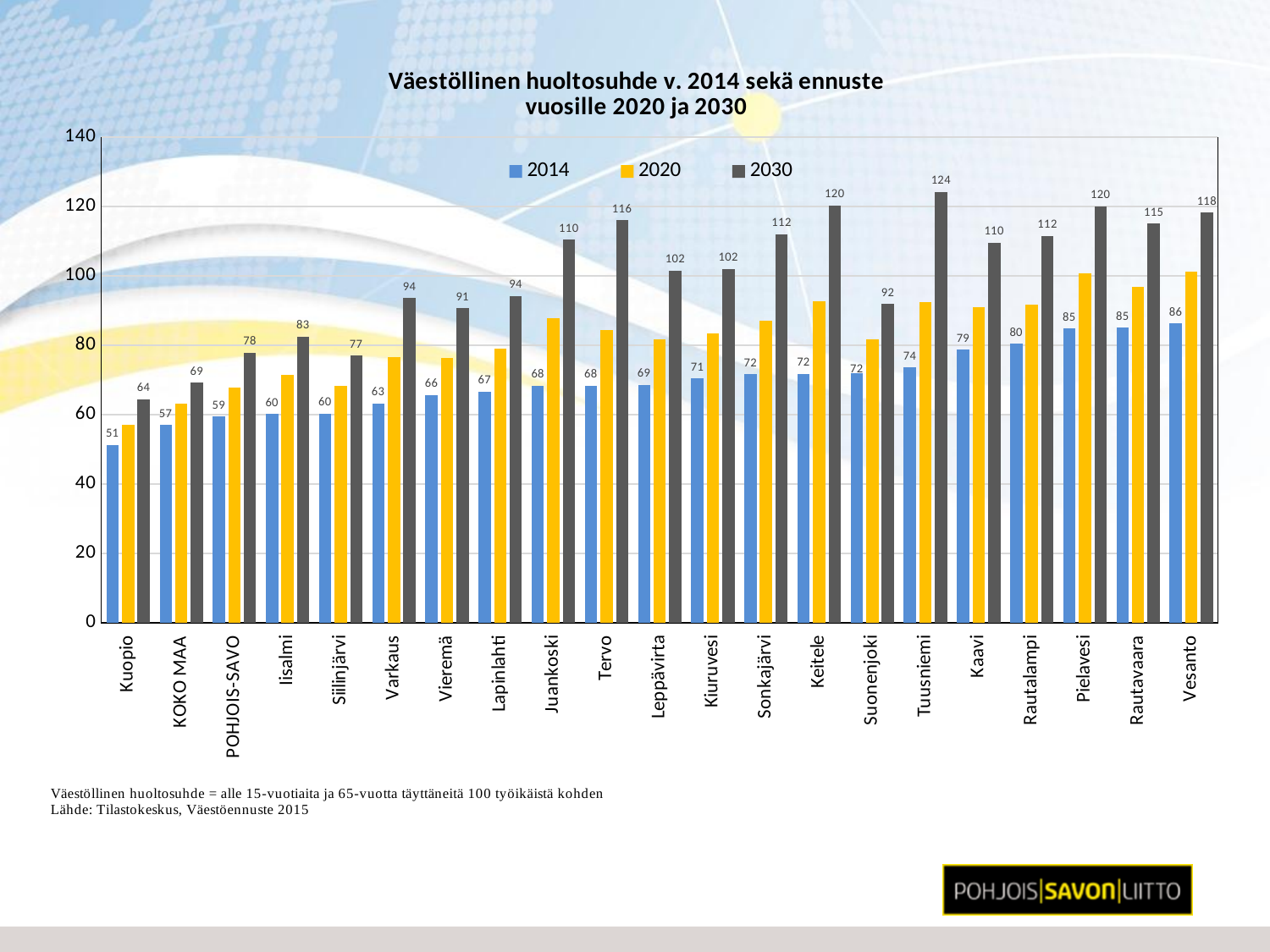
What is the 2030 value for Tervo? 116 Which category has the highest 2030 value? Tuusniemi What kind of chart is shown on the slide? bar chart Which category has the lowest 2014 value? Kuopio Is the 2020 value for Keitele greater or less than 80? greater What is the 2014 value for Vesanto? 86 How many categories are shown on the x axis? 21 What is the 2014 value for Kuopio? 51 How many series does the legend list? 3 What is the difference between the 2030 and 2014 values for Tuusniemi? 50 Which is larger, the 2030 value for Keitele or the 2030 value for Sonkajärvi? Keitele Do the 2014 values generally rise or fall from left to right along the x axis? rise